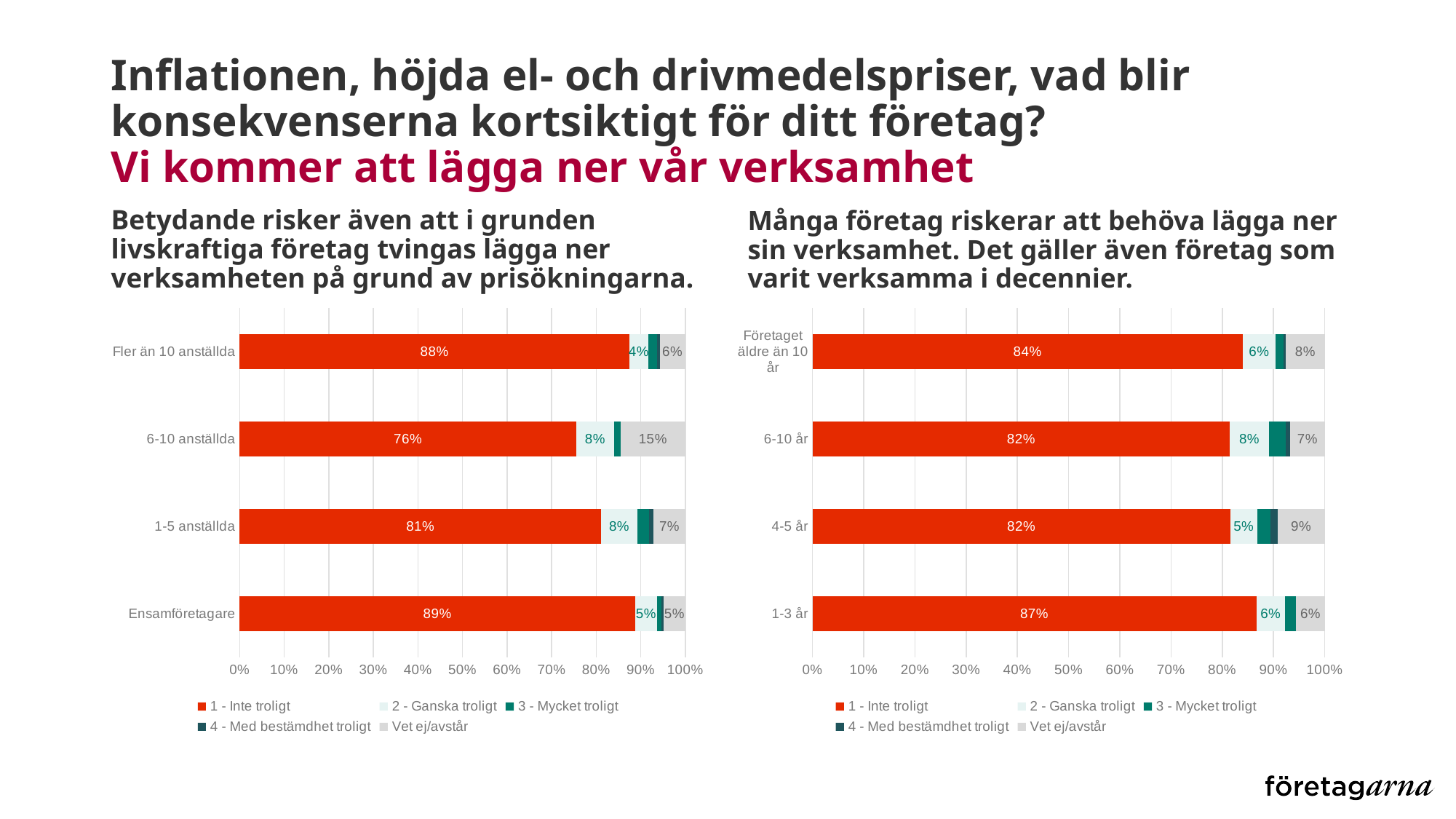
In the right chart, what is the '1 - Inte troligt' value for '1-3 år'? 87% In the left chart, what is the 'Vet ej/avstår' value for '6-10 anställda'? 15% In the left chart, what is the value of '1 - Inte troligt' for 'Fler än 10 anställda'? 88% In the right chart, which is larger: the '2 - Ganska troligt' value for '6-10 år' or for '4-5 år'? 6-10 år How many series does the legend of the left chart list? 5 In the right chart, which category has the highest '1 - Inte troligt' value? 1-3 år In the left chart, which category has the highest '1 - Inte troligt' value? Ensamföretagare In the right chart, what is the 'Vet ej/avstår' value for '4-5 år'? 9% What type of chart is the left chart? Stacked bar chart In the left chart, which category has the lowest '1 - Inte troligt' value? 6-10 anställda How many categories are shown in the right chart? 4 In the left chart, what is the difference between the '1 - Inte troligt' values for 'Ensamföretagare' and '6-10 anställda'? 13%